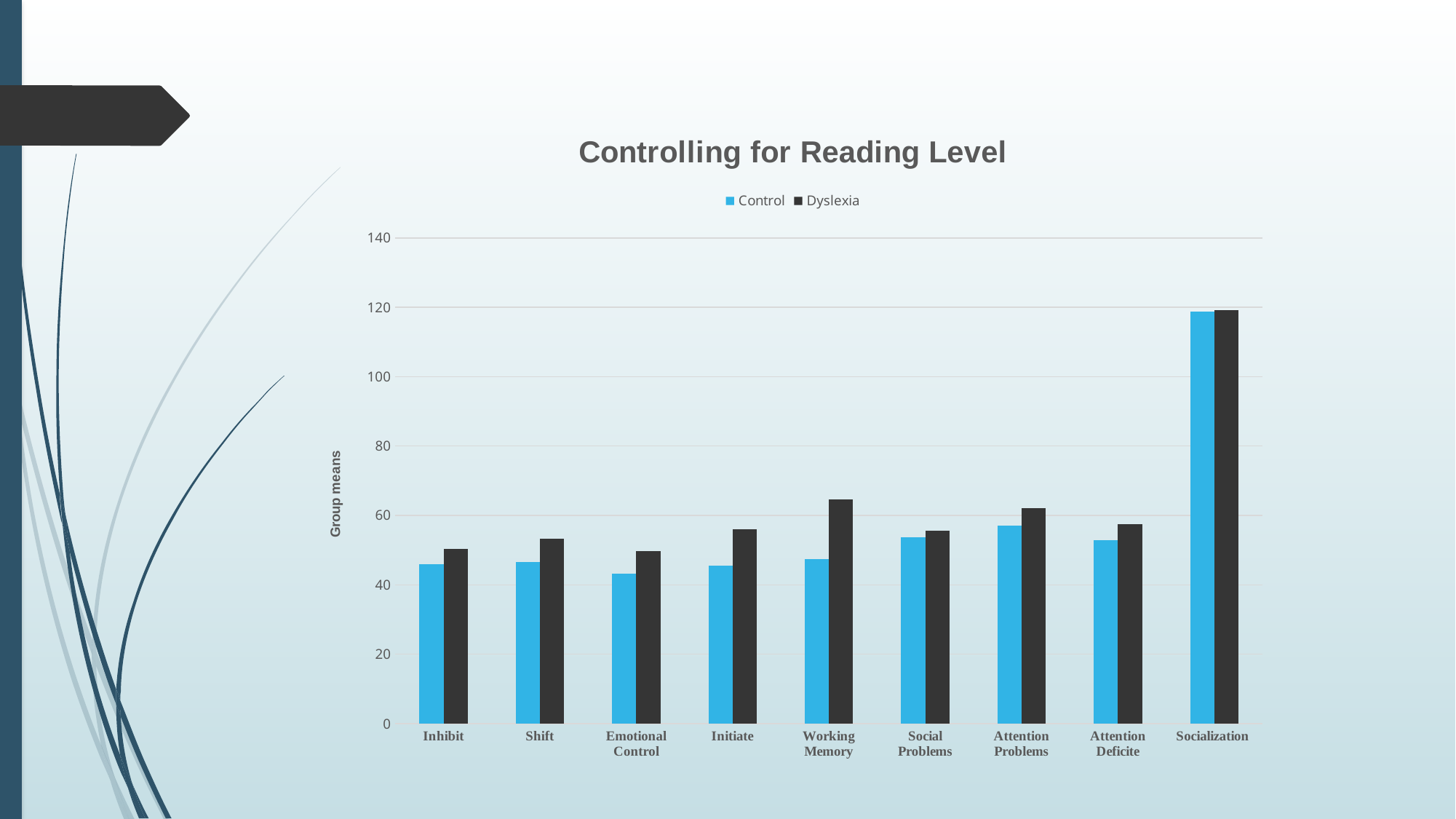
Is the Dyslexia value for Working Memory greater or less than 60? greater Which category has the lowest value for the Control series? Emotional Control Which category has the highest value for the Dyslexia series? Socialization What is the label of the vertical axis? Group means Which category has the highest value for the Control series? Socialization For Working Memory, which series has the larger value, Control or Dyslexia? Dyslexia What type of chart is shown on the slide? bar chart How many series does the legend list? 2 What is the title of the chart? Controlling for Reading Level Is the Control value for Initiate greater or less than 60? less Is the Control value for Socialization greater or less than 100? greater How many categories are shown on the x axis? 9